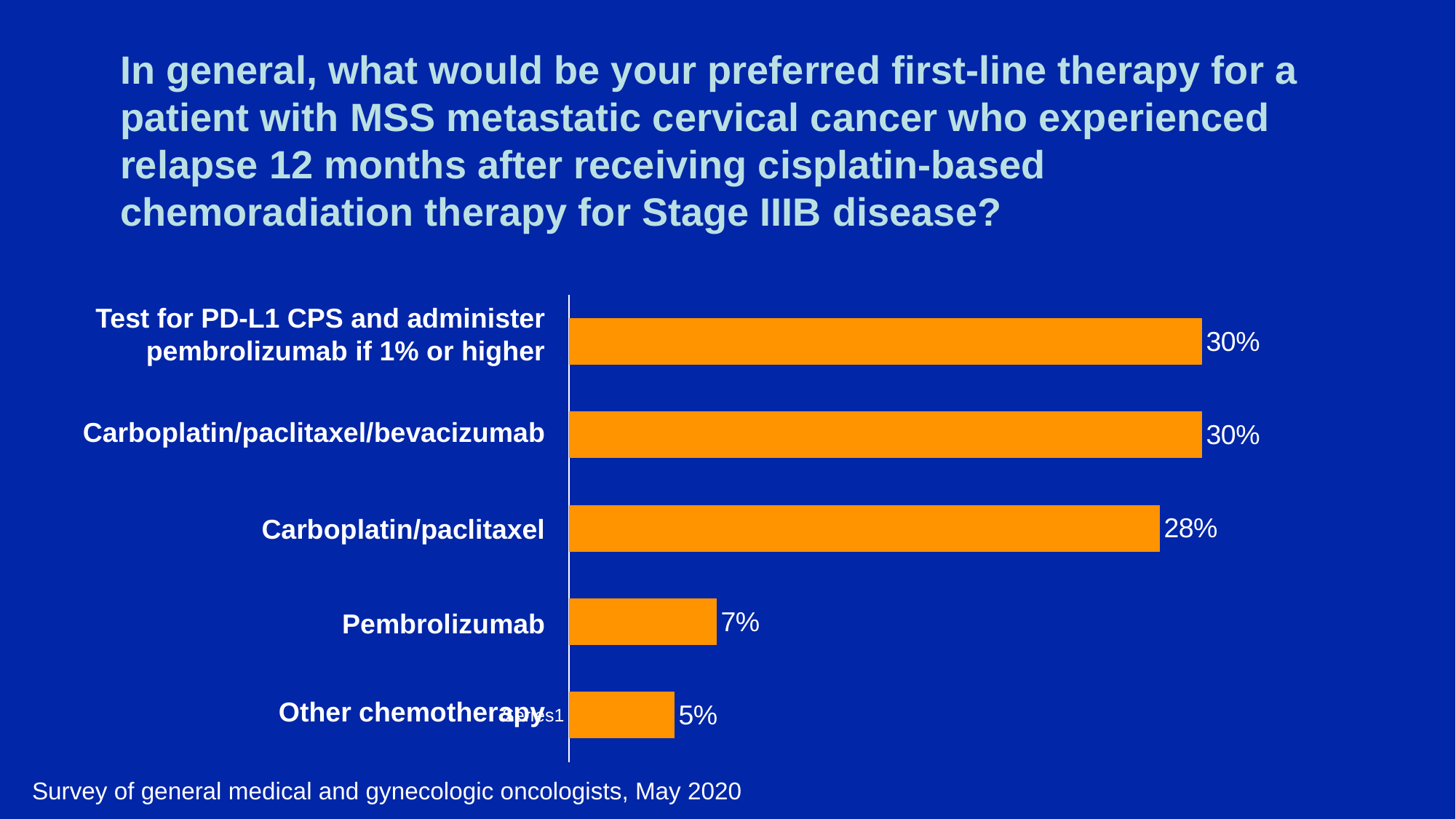
What percentage of respondents chose Carboplatin/paclitaxel/bevacizumab? 30% How many response options are shown in the chart? 5 Which received a larger share of responses, Carboplatin/paclitaxel or Pembrolizumab? Carboplatin/paclitaxel Which option received the lowest percentage of responses? Other chemotherapy What colour are the bars in the chart? Orange What percentage of respondents chose Carboplatin/paclitaxel? 28% What is the difference in percentage points between Pembrolizumab and Other chemotherapy? 2 percentage points What type of chart is shown on the slide? Bar chart What percentage of respondents chose Pembrolizumab? 7% What percentage of respondents chose Other chemotherapy? 5% What percentage of respondents chose to test for PD-L1 CPS and administer pembrolizumab if 1% or higher? 30% What is the difference in percentage points between Carboplatin/paclitaxel/bevacizumab and Carboplatin/paclitaxel? 2 percentage points